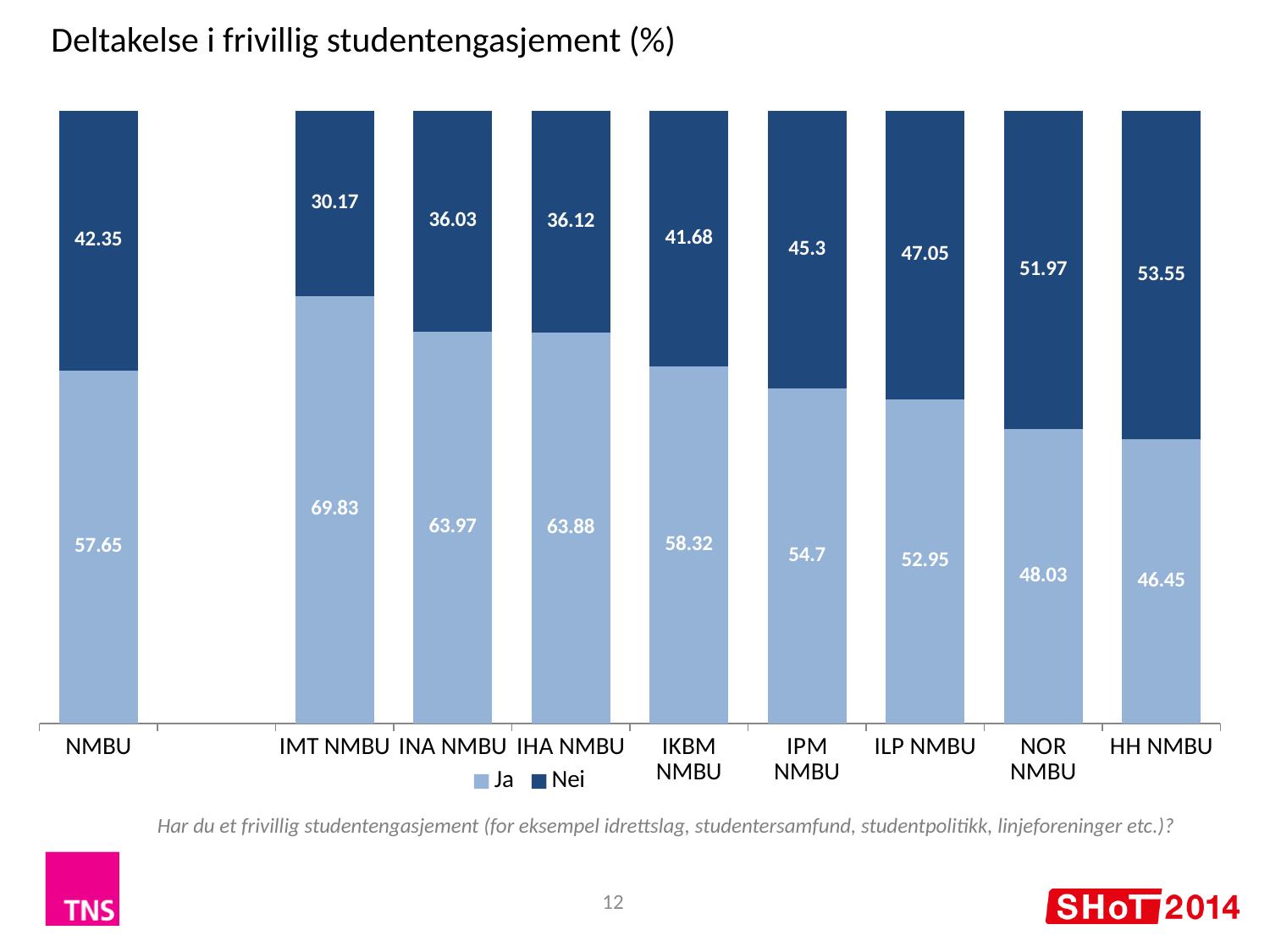
What is the 'Nei' value for HH NMBU? 53.55 What is the 'Ja' value for IMT NMBU? 69.83 What is the 'Ja' value for NMBU? 57.65 Which category has the lowest 'Nei' value? IMT NMBU What is the difference between the 'Ja' values for IMT NMBU and HH NMBU? 23.38 How many categories are shown on the x axis? 9 What kind of chart is shown? Stacked bar chart Which is larger, the 'Ja' value for IKBM NMBU or the 'Ja' value for IPM NMBU? IKBM NMBU Which category has the highest 'Ja' value? IMT NMBU What is the total of the stacked bar for NOR NMBU? 100 Which category has the lowest 'Ja' value? HH NMBU How many series does the legend list? 2